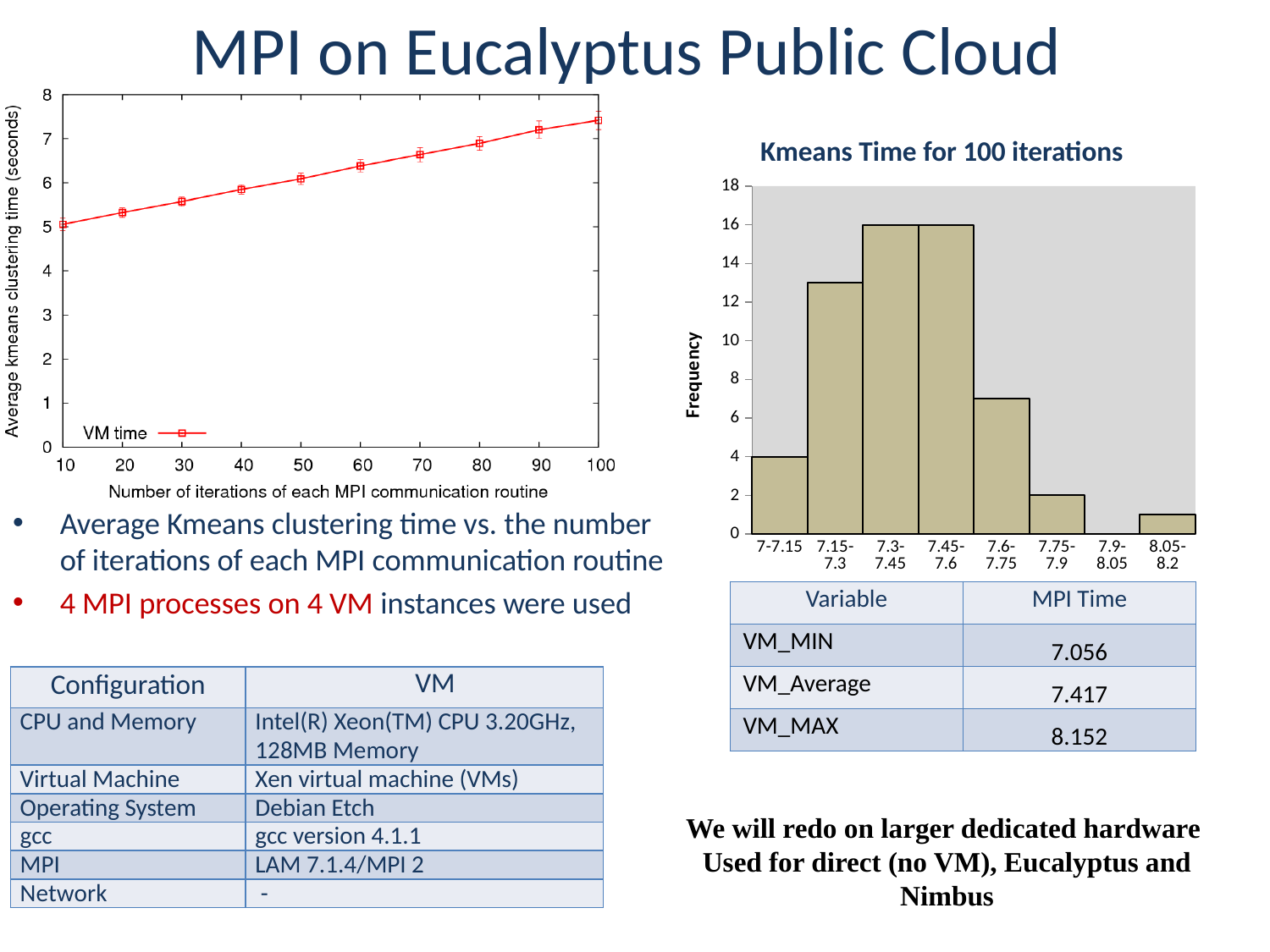
What type of chart is the 'Kmeans Time for 100 iterations' chart? bar chart What series name is shown in the legend of the left line chart? VM time How many data points are plotted in the left line chart? 10 In the left line chart, is the value at 10 iterations greater or less than 6? less In the 'Kmeans Time for 100 iterations' chart, what is the frequency for the 7.75-7.9 bin? 2 In the left line chart, does the average Kmeans clustering time rise or fall as the number of iterations increases? rise What type of chart is the chart on the left of the slide? line chart In the left line chart, is the value at 100 iterations greater or less than 7? greater In the 'Kmeans Time for 100 iterations' chart, what is the frequency for the 7-7.15 bin? 4 In the 'Kmeans Time for 100 iterations' chart, which bin has the lowest frequency? 7.9-8.05 How many bins are shown in the 'Kmeans Time for 100 iterations' chart? 8 In the 'Kmeans Time for 100 iterations' chart, what is the frequency for the 7.45-7.6 bin? 16